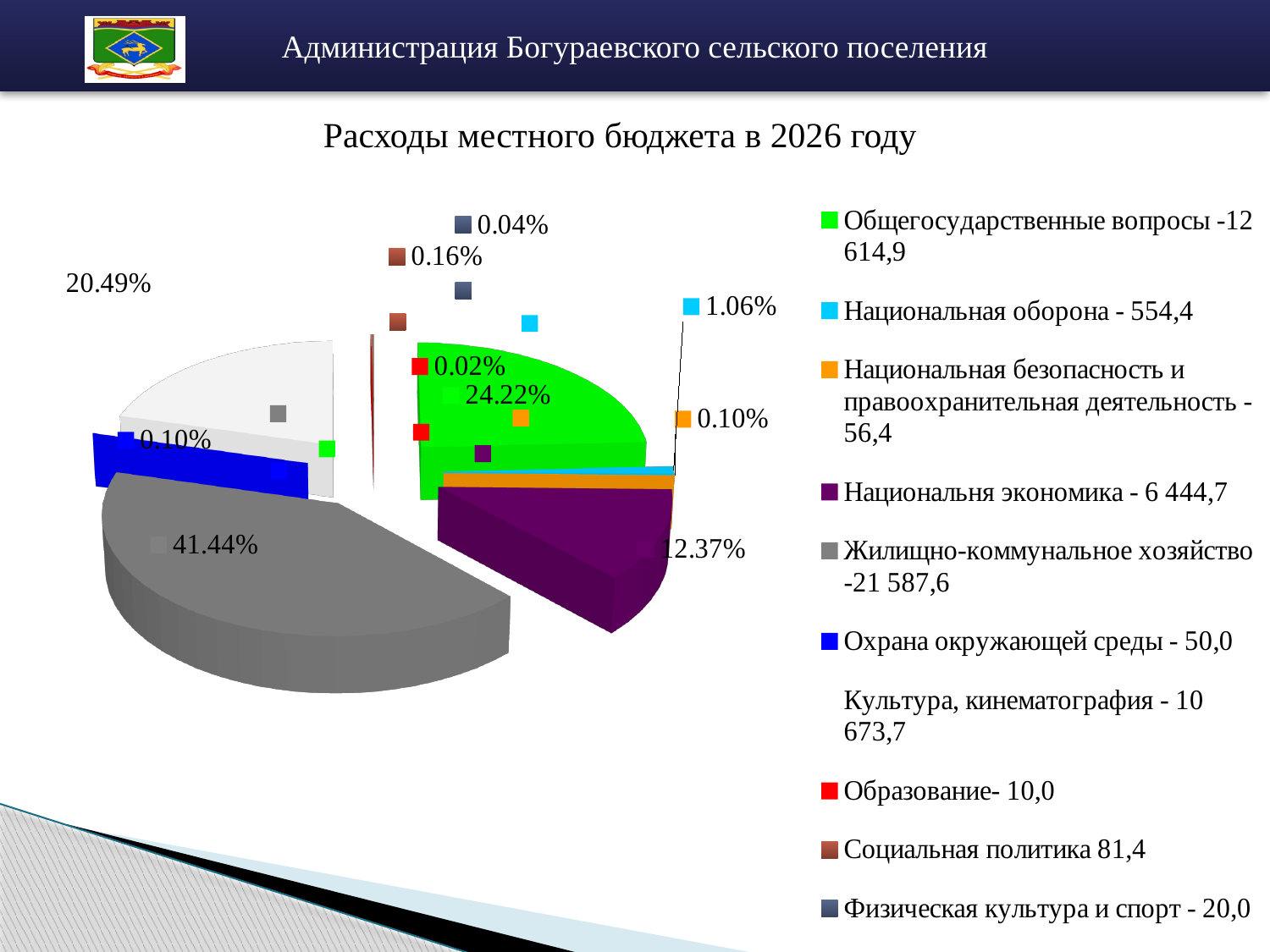
Which category has the largest slice of the pie? Жилищно-коммунальное хозяйство What is the title of the chart? Расходы местного бюджета в 2026 году What kind of chart is shown on the slide? pie chart Which slice is larger: Общегосударственные вопросы or Национальня экономика? Общегосударственные вопросы What value does the legend give for Культура, кинематография? 10 673,7 What share of the pie does Национальня экономика take? 12.37% What share of the pie does Жилищно-коммунальное хозяйство take? 41.44% How many categories does the legend list? 10 What value does the legend give for Национальная оборона? 554,4 Which category has the smallest slice of the pie? Образование What share of the pie does Общегосударственные вопросы take? 24.22%